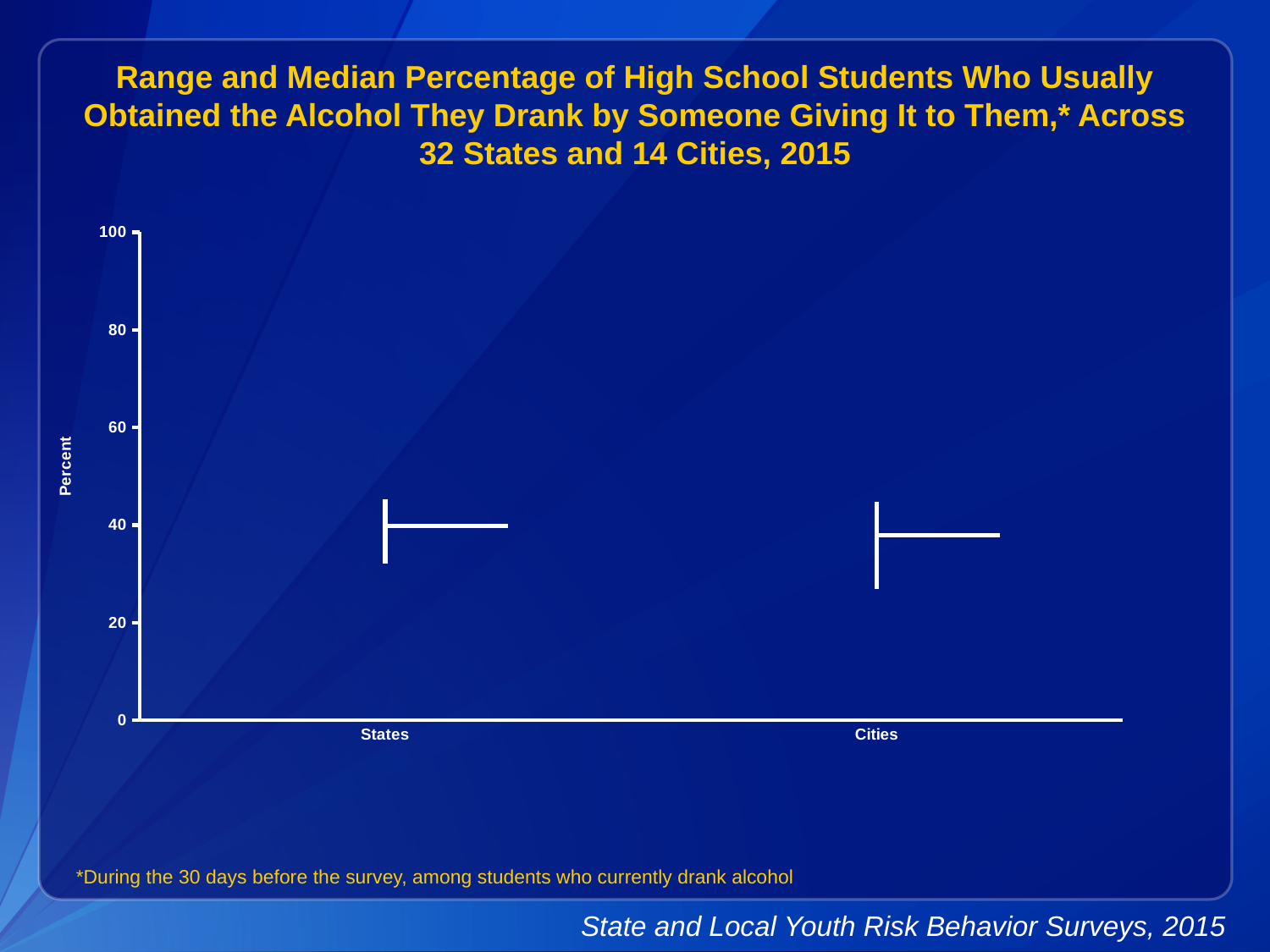
What are the two categories shown on the x axis? States and Cities What is the highest value shown on the y axis? 100 Is the median value for States greater or less than 20? greater How many categories are shown on the x axis of the chart? 2 Is the bottom of the range for Cities greater or less than 20? greater What is the label of the y axis? Percent Is the top of the range for States greater or less than 60? less Which category has the lower bottom of its range, States or Cities? Cities